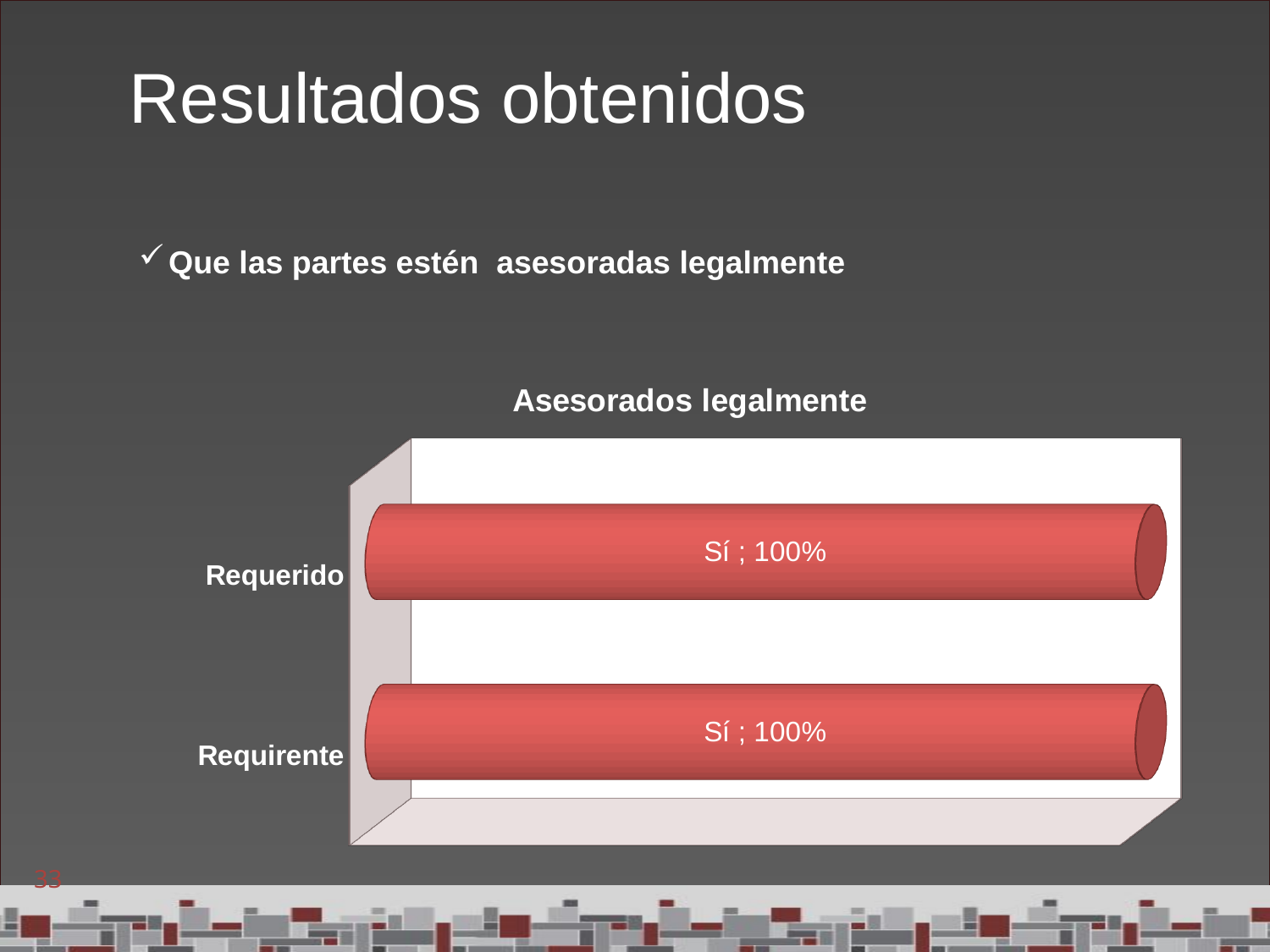
Is the value for Requerido greater than or equal to 100%? equal What is the title of the chart? Asesorados legalmente What response label is shown on the bars in the chart? Sí What is the difference between the values for Requerido and Requirente? 0% What is the value shown for Requirente? 100% How many categories does the chart show? 2 What kind of chart is shown on the slide? bar chart What is the value shown for Requerido? 100%